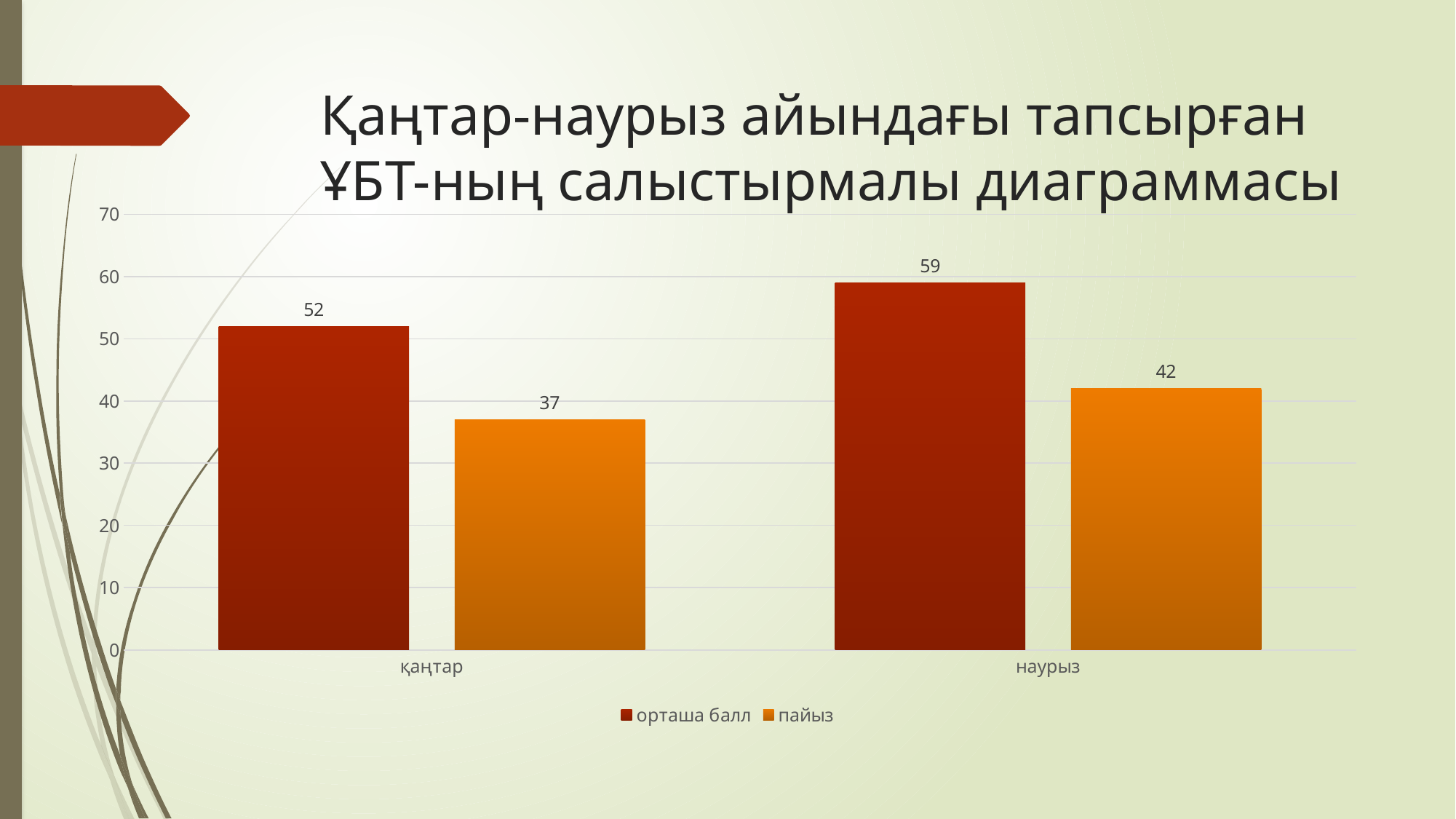
What is the value of орташа балл for наурыз? 59 What is the difference between the орташа балл values for наурыз and қаңтар? 7 Does the пайыз value rise or fall from қаңтар to наурыз? rise Which category has the lowest пайыз value? қаңтар Which is larger: орташа балл for қаңтар or пайыз for наурыз? орташа балл for қаңтар Which category has the highest орташа балл value? наурыз What kind of chart is shown on the slide? bar chart What is the value of пайыз for наурыз? 42 How many categories are shown on the x axis? 2 What is the value of пайыз for қаңтар? 37 How many series does the legend list? 2 What is the value of орташа балл for қаңтар? 52